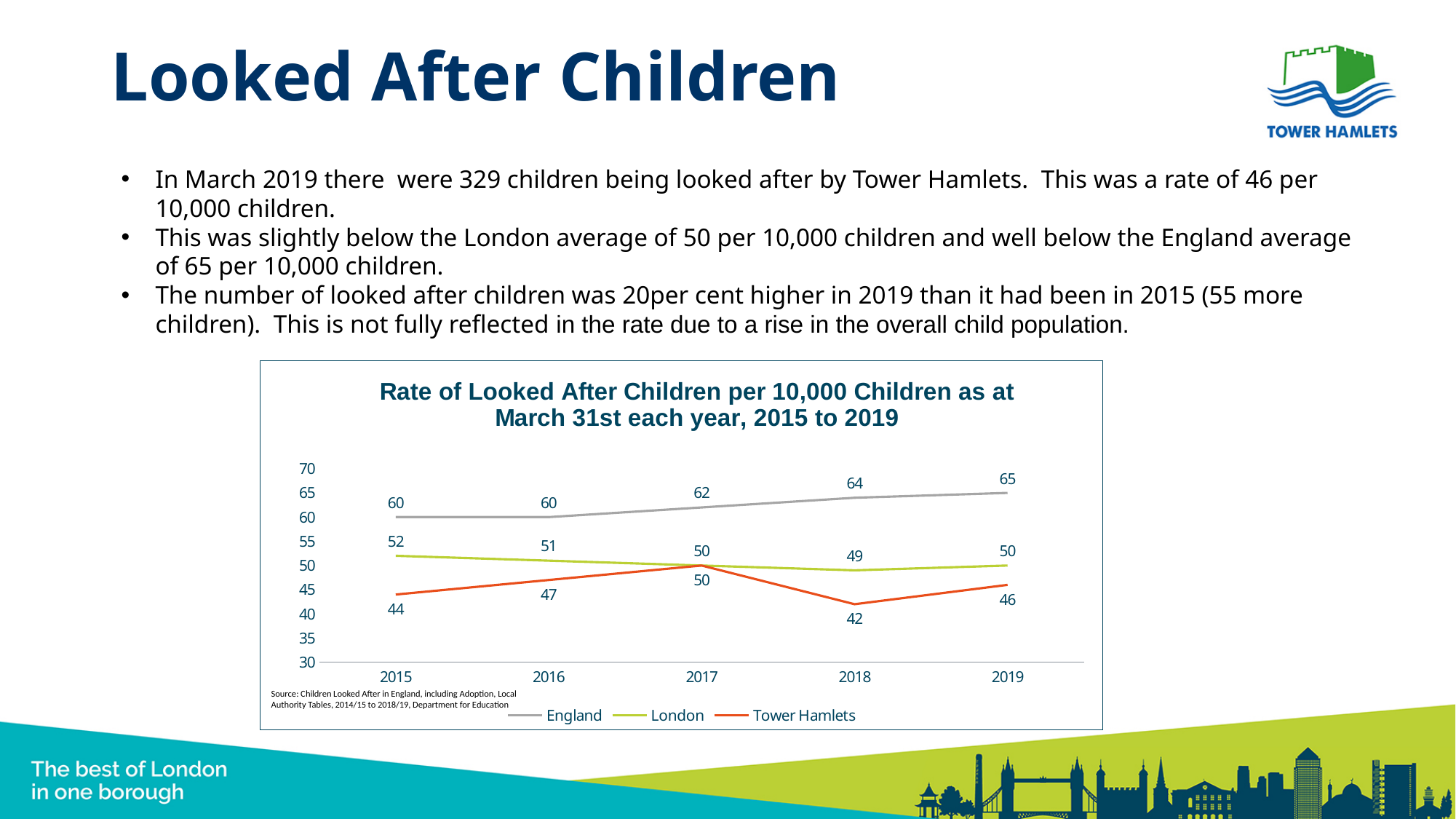
What is the difference between the England rate and the Tower Hamlets rate in 2019? 19 In which year was the Tower Hamlets rate highest? 2017 Which had the higher rate in 2016, London or Tower Hamlets? London How many series does the chart legend list? 3 Does the England rate rise or fall from 2015 to 2019? Rise How many years are shown on the x axis of the chart? 5 In which year was the Tower Hamlets rate lowest? 2018 What was the rate of looked after children per 10,000 for Tower Hamlets in 2018? 42 What was the England rate of looked after children per 10,000 in 2017? 62 What is the title of the chart? Rate of Looked After Children per 10,000 Children as at March 31st each year, 2015 to 2019 What type of chart is shown on the slide? Line chart What was the London rate of looked after children per 10,000 in 2015? 52